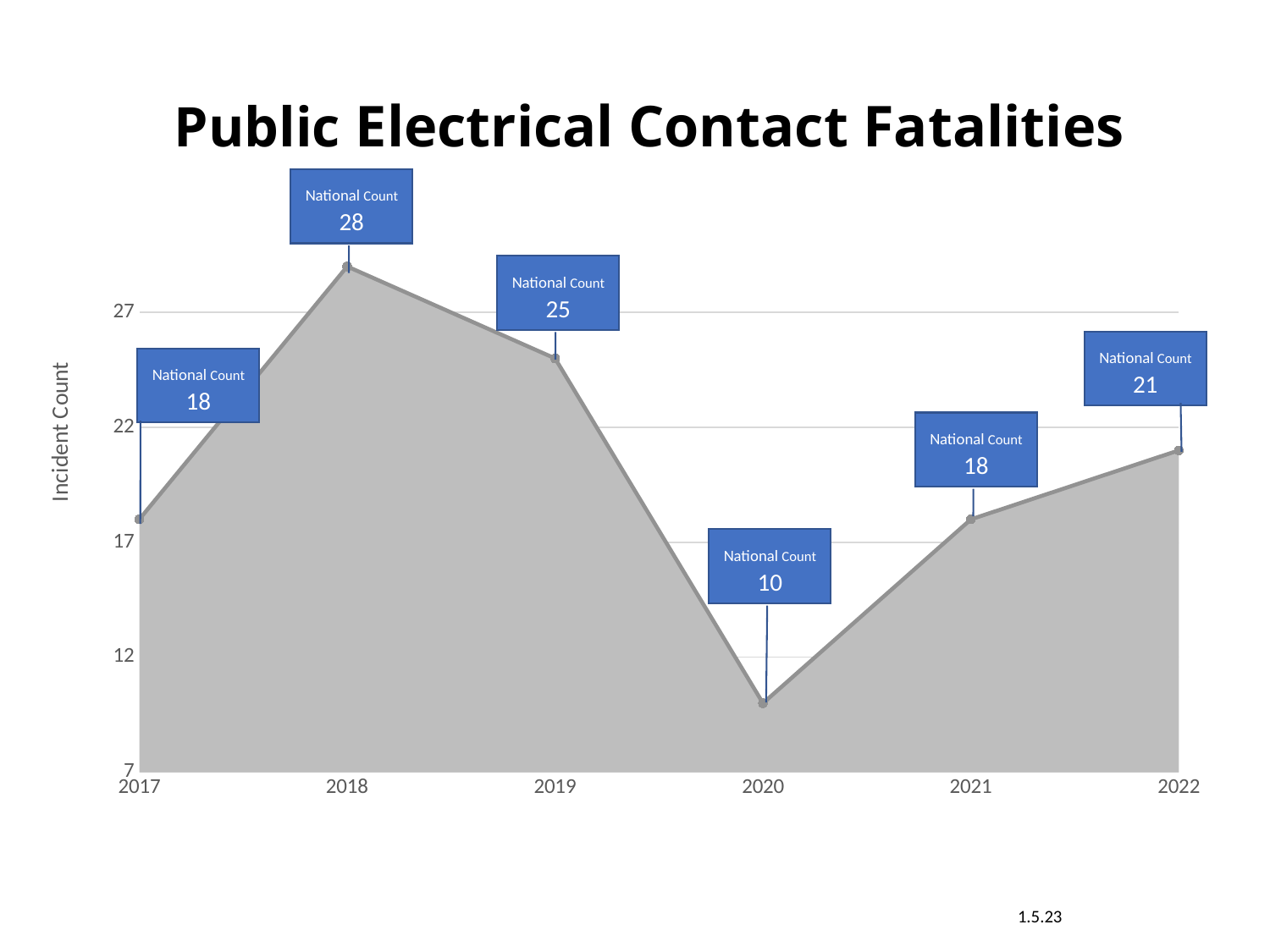
What is the difference between the National Count in 2019 and in 2022? 4 What is the National Count for 2020? 10 Which year has the highest National Count? 2018 What is the title of the chart? Public Electrical Contact Fatalities What is the National Count for 2018? 28 Does the National Count rise or fall from 2020 to 2022? Rise Which year has the lowest National Count? 2020 What kind of chart is shown on the slide? Area chart What is the difference between the National Count in 2018 and in 2020? 18 Which year has a larger National Count, 2019 or 2021? 2019 What is the National Count for 2022? 21 How many years are plotted on the x axis? 6